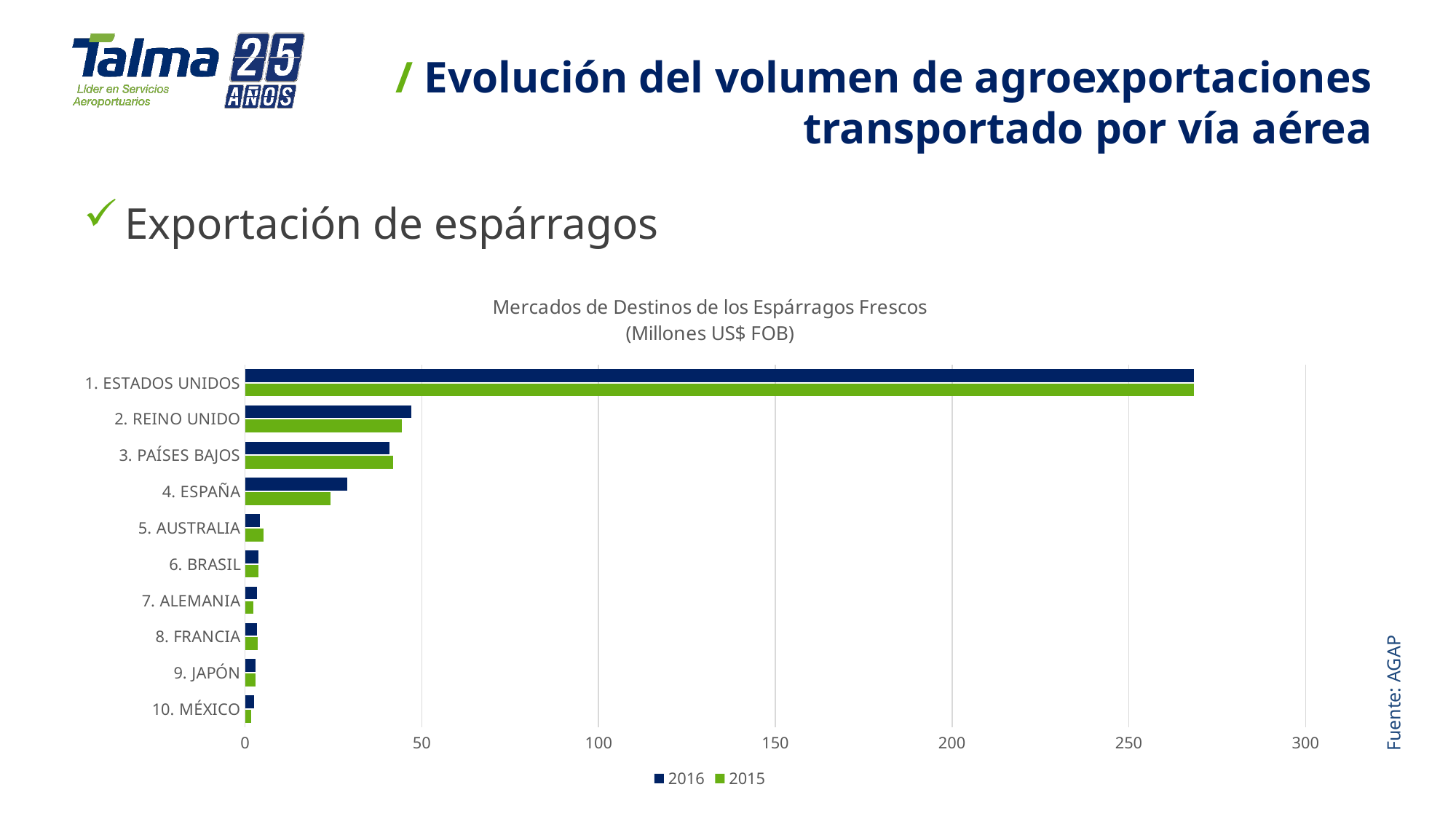
How many series does the legend list? 2 What is the title of the chart? Mercados de Destinos de los Espárragos Frescos (Millones US$ FOB) Which is larger for 2016: REINO UNIDO or PAÍSES BAJOS? REINO UNIDO What kind of chart is shown on the slide? bar chart For ESPAÑA, which year has the larger value, 2016 or 2015? 2016 Is the 2016 value for REINO UNIDO greater or less than 50? less Is the 2015 value for ESPAÑA greater or less than 50? less Which colour represents the 2015 series in the legend? green Which is larger for 2016: REINO UNIDO or ESPAÑA? REINO UNIDO Is the 2016 value for ESTADOS UNIDOS greater or less than 250? greater Which destination market has the highest value for 2016? 1. ESTADOS UNIDOS How many destination markets are listed on the chart? 10